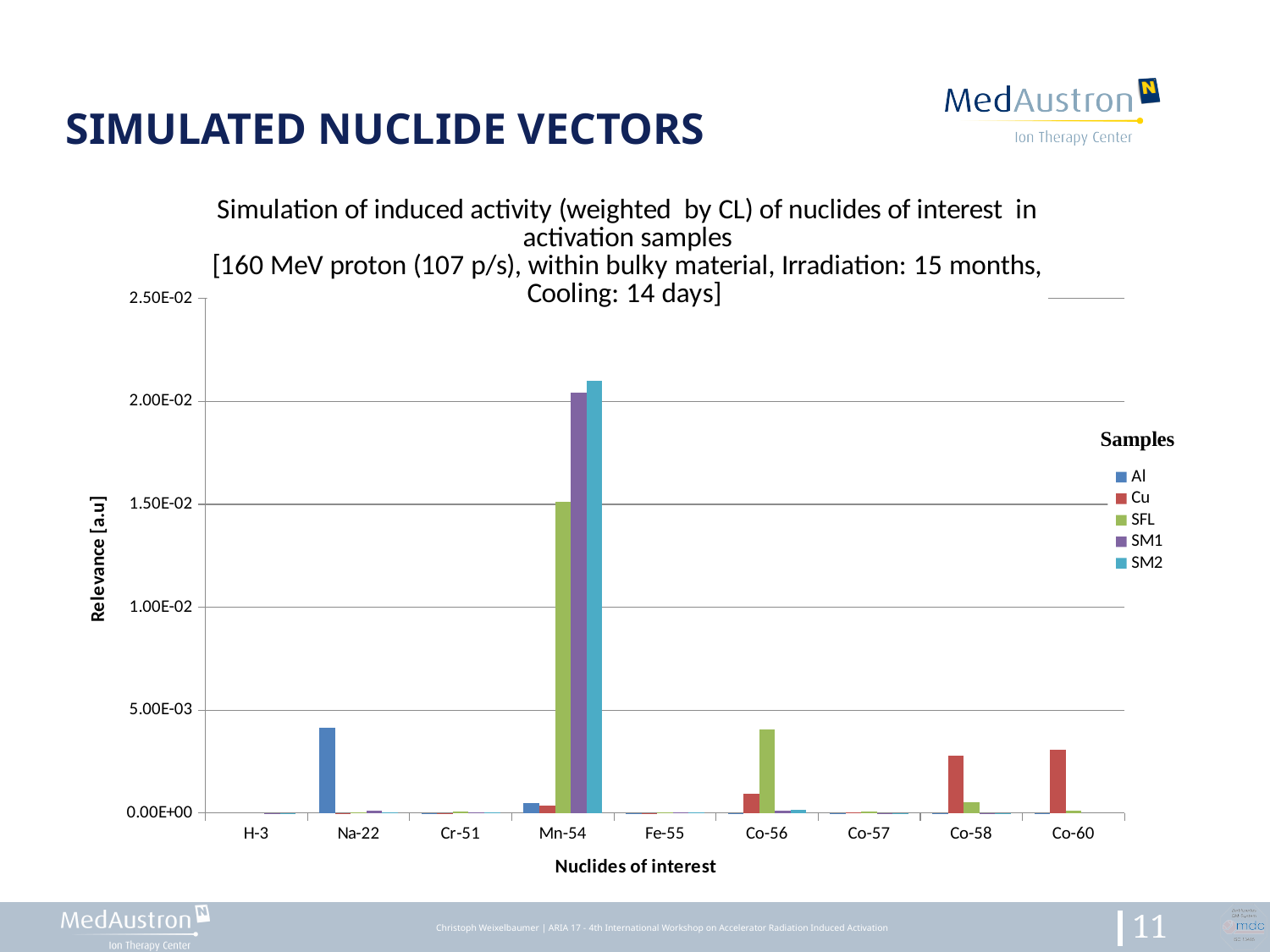
Is the value for Al at Na-22 greater or less than 5.00E-03? less What kind of chart is shown on the slide? bar chart Which sample has the highest value at Na-22? Al Is the value for SFL at Mn-54 greater or less than 1.00E-02? greater Which sample has the highest value at Co-58? Cu What is the label of the y axis? Relevance [a.u] Is the value for SM2 at Mn-54 greater or less than 2.00E-02? greater For which nuclide are the plotted values highest overall? Mn-54 How many samples (series) does the legend list? 5 What is the title of the legend? Samples At Co-56, which is larger: the value for SFL or the value for Cu? SFL How many nuclides (categories) are shown along the x axis? 9